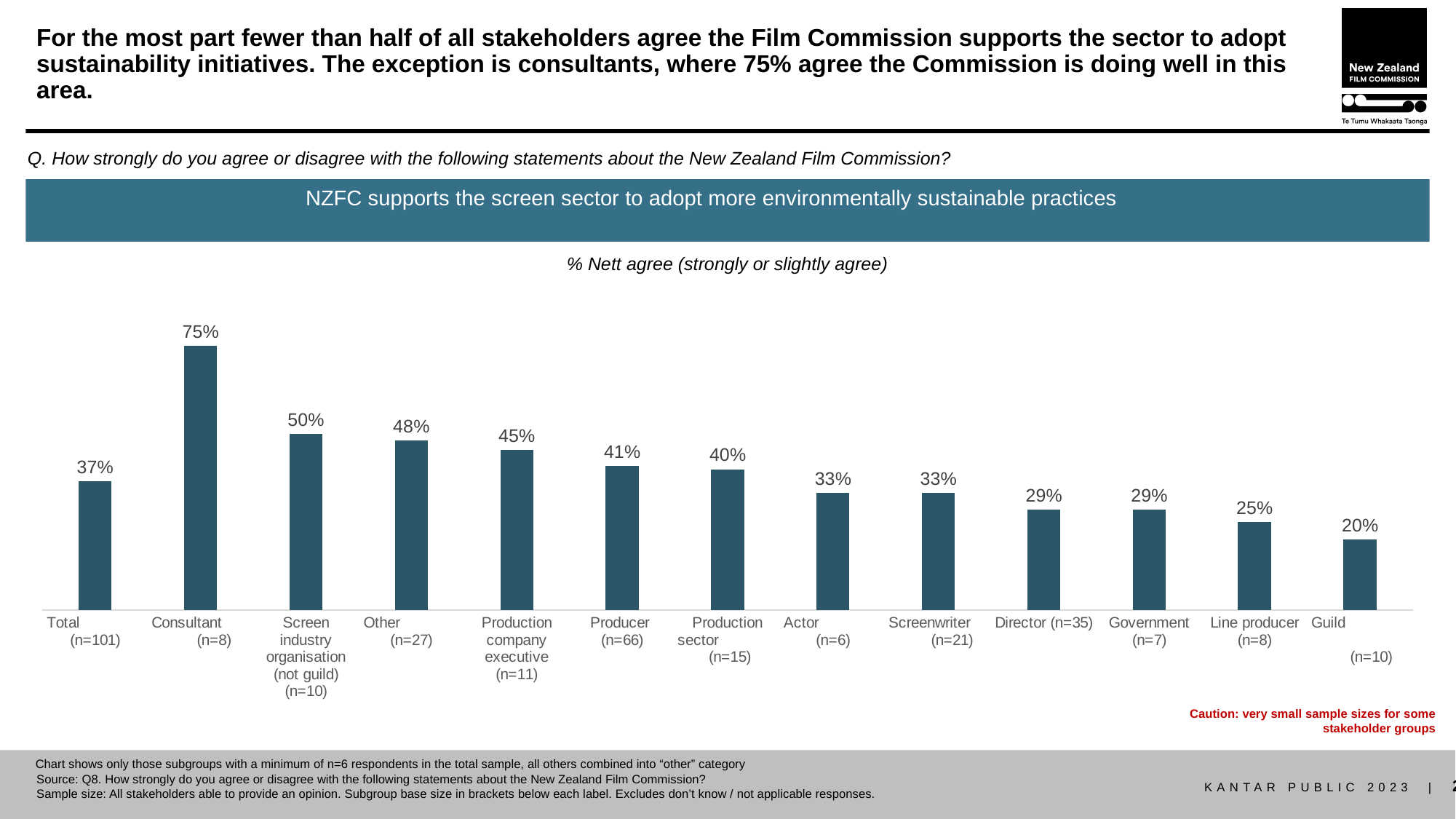
Which stakeholder group has the highest % nett agree? Consultant What is the % nett agree value for Consultant (n=8)? 75% What is the difference in % nett agree between Screen industry organisation (not guild) and Total? 13 percentage points What kind of chart is shown on the slide? Bar chart Which has a higher % nett agree, Production company executive or Production sector? Production company executive What is the title shown in the teal banner above the chart? NZFC supports the screen sector to adopt more environmentally sustainable practices Which stakeholder group has the lowest % nett agree? Guild What is the % nett agree value for Line producer (n=8)? 25% What is the difference in % nett agree between Consultant and Guild? 55 percentage points How many stakeholder groups (bars) are shown in the chart? 13 What is the % nett agree value for Total (n=101)? 37% What is the % nett agree value for Producer (n=66)? 41%